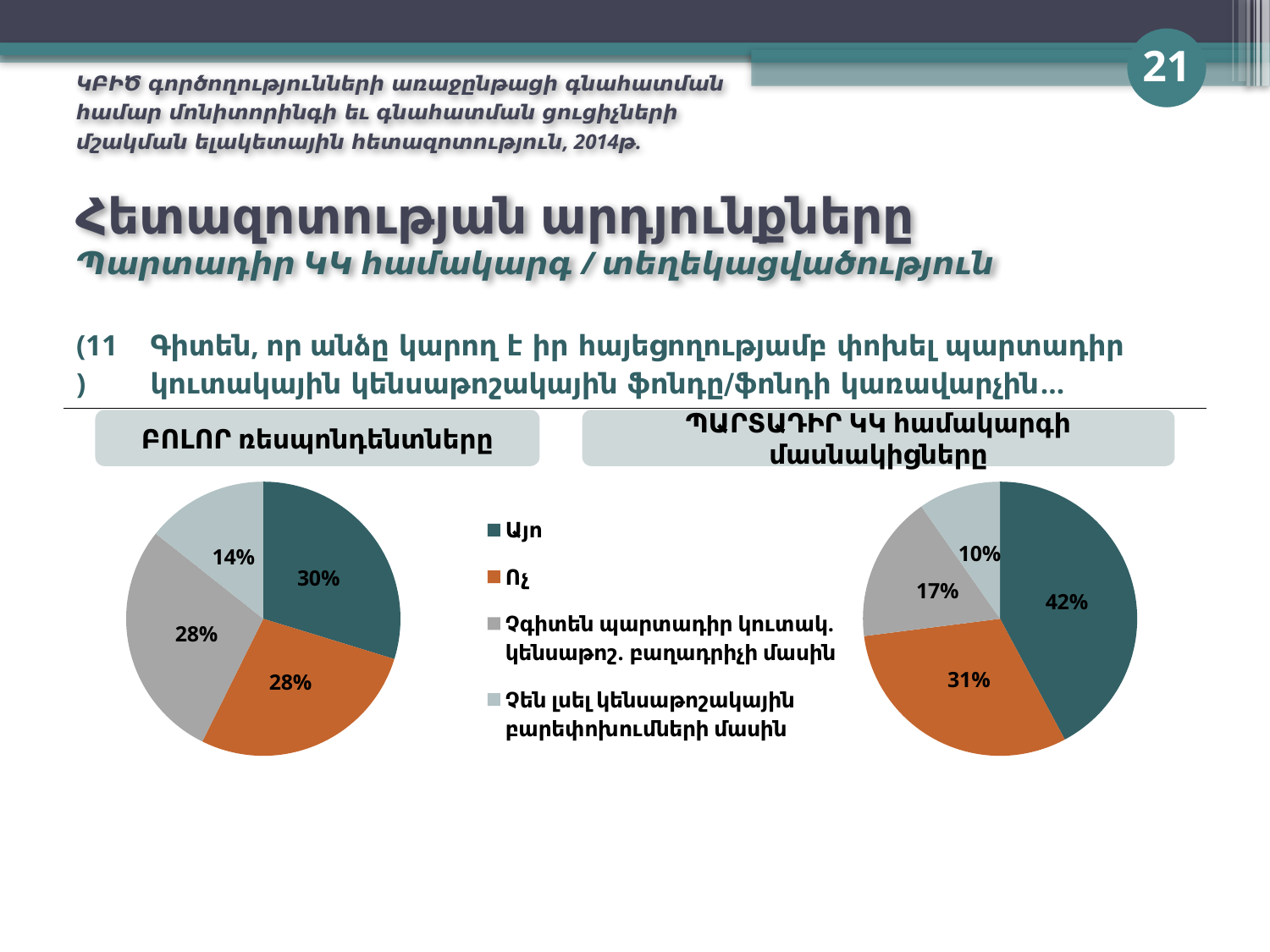
In the right pie chart (ՊԱՐՏԱԴԻՐ ԿԿ համակարգի մասնակիցները), what share is labelled for Այո? 42% In the left pie chart (ԲՈԼՈՐ ռեսպոնդենտները), what is the smallest slice's share? 14% In the right pie chart (ՊԱՐՏԱԴԻՐ ԿԿ համակարգի մասնակիցները), which category has the largest slice? Այո In the left pie chart (ԲՈԼՈՐ ռեսպոնդենտները), what share is labelled for Այո? 30% In the right pie chart (ՊԱՐՏԱԴԻՐ ԿԿ համակարգի մասնակիցները), what is the smallest slice's share? 10% How many slices does each pie chart have? 4 Which chart has the larger Ոչ share, the left pie chart or the right pie chart? The right pie chart What kind of charts are shown on the slide? Pie charts How many entries does the legend list? 4 In the right pie chart (ՊԱՐՏԱԴԻՐ ԿԿ համակարգի մասնակիցները), what share is labelled for Ոչ? 31% In the left pie chart (ԲՈԼՈՐ ռեսպոնդենտները), what share is labelled for Ոչ? 28% What is the difference between the Այո share in the right pie chart (42%) and the Այո share in the left pie chart (30%)? 12%